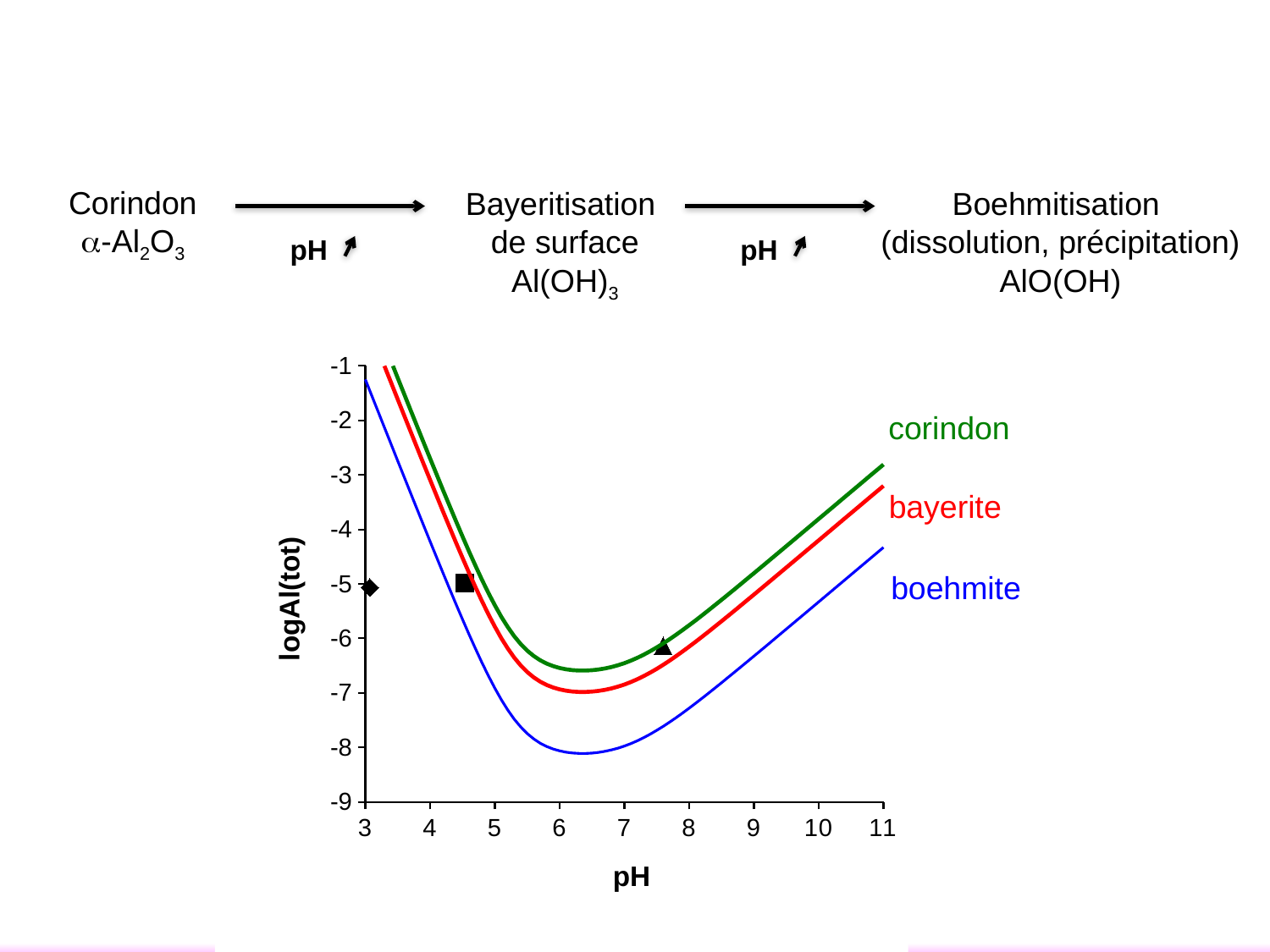
Do the curves rise or fall as pH increases from 7 to 11? rise Is the logAl(tot) value of the corindon curve at pH 11 greater or less than -3? greater Which curve lies highest on the chart across the pH range? corindon Is the logAl(tot) value of the boehmite curve at pH 11 greater or less than -4? less What kind of chart is shown on the slide? line chart Is the minimum logAl(tot) value of the boehmite curve greater or less than -7? less Do the curves rise or fall as pH increases from 3 to 6? fall At pH 9, which is larger, the logAl(tot) value for corindon or for boehmite? corindon How many curves (series) are labelled on the chart? 3 Which curve lies lowest on the chart across the pH range? boehmite What is the label of the y axis of the chart? logAl(tot)